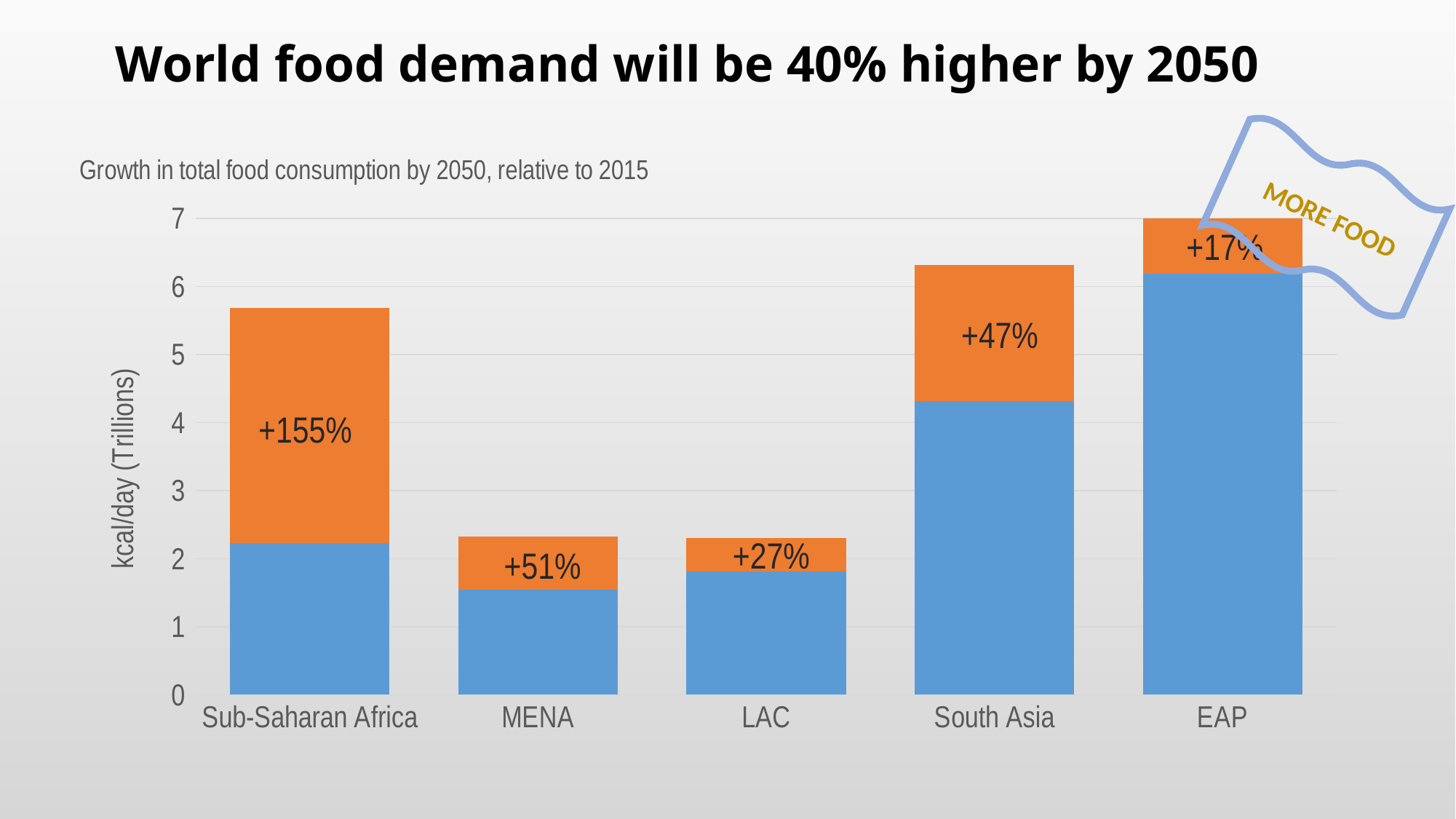
How many regions are shown on the x axis of the chart? 5 What kind of chart is shown on the slide? stacked bar chart What growth percentage is labelled on the bar for MENA? +51% What is the label on the vertical axis of the chart? kcal/day (Trillions) Which region has the taller total bar, EAP or South Asia? EAP What growth percentage is labelled on the bar for Sub-Saharan Africa? +155% Which region has the lowest labelled growth percentage? EAP Is the blue portion of the LAC bar greater or less than 2? less Which region has the highest labelled growth percentage? Sub-Saharan Africa Is the total height of the South Asia bar greater or less than 6? greater What growth percentage is labelled on the bar for EAP? +17% What growth percentage is labelled on the bar for South Asia? +47%